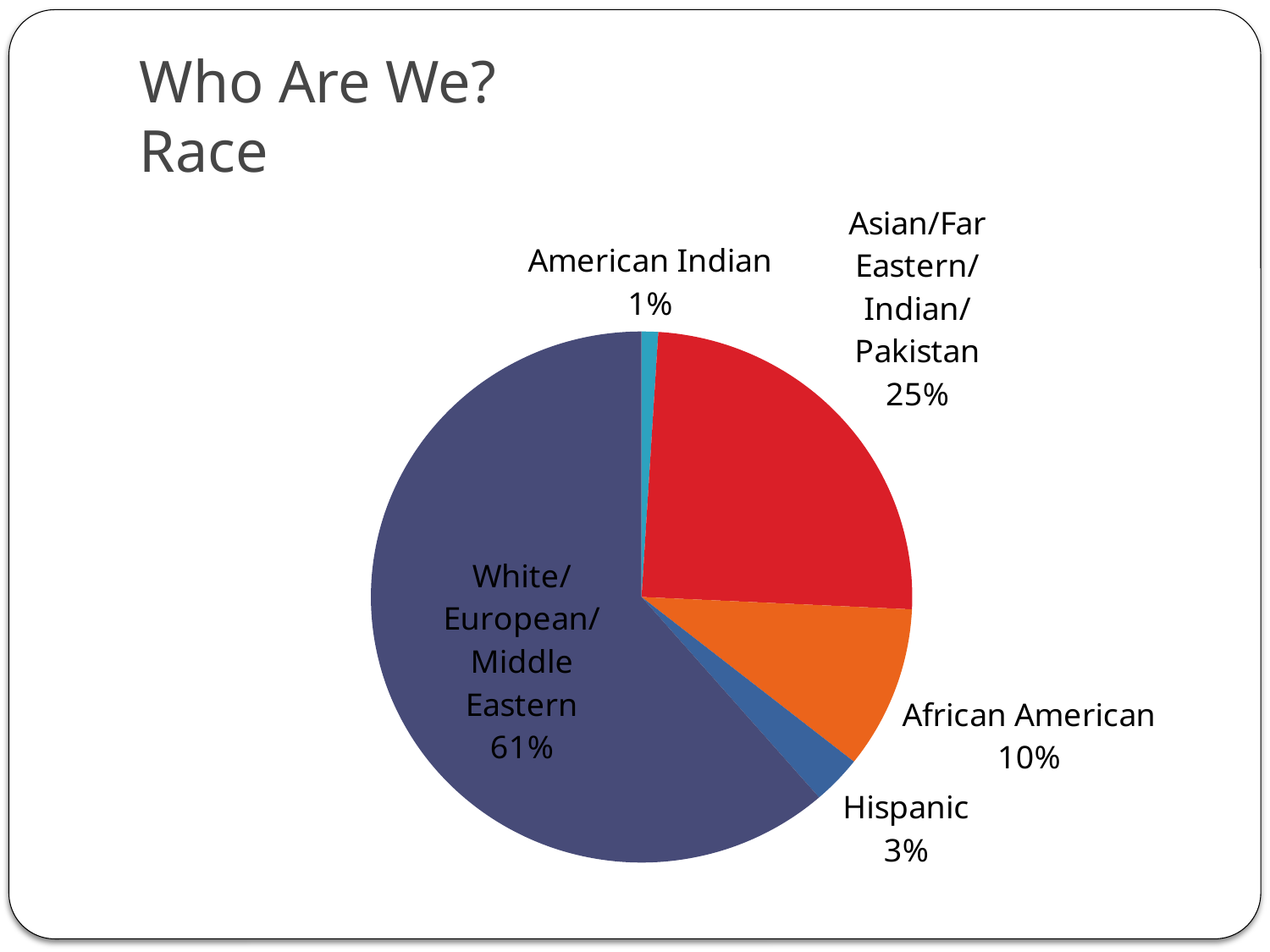
What is the difference between the White/European/Middle Eastern share and the Asian/Far Eastern/Indian/Pakistan share? 36% Which category has the smallest slice of the pie? American Indian What is the value for Hispanic? 3% What is the value for American Indian? 1% What is the title of the slide containing the chart? Who Are We? Race What share of the pie does White/European/Middle Eastern represent? 61% Which is larger, the African American share or the Hispanic share? African American Which category has the largest slice of the pie? White/European/Middle Eastern What kind of chart is shown on the slide? pie chart How many categories are shown in the pie chart? 5 What is the value for African American? 10% What is the value for Asian/Far Eastern/Indian/Pakistan? 25%